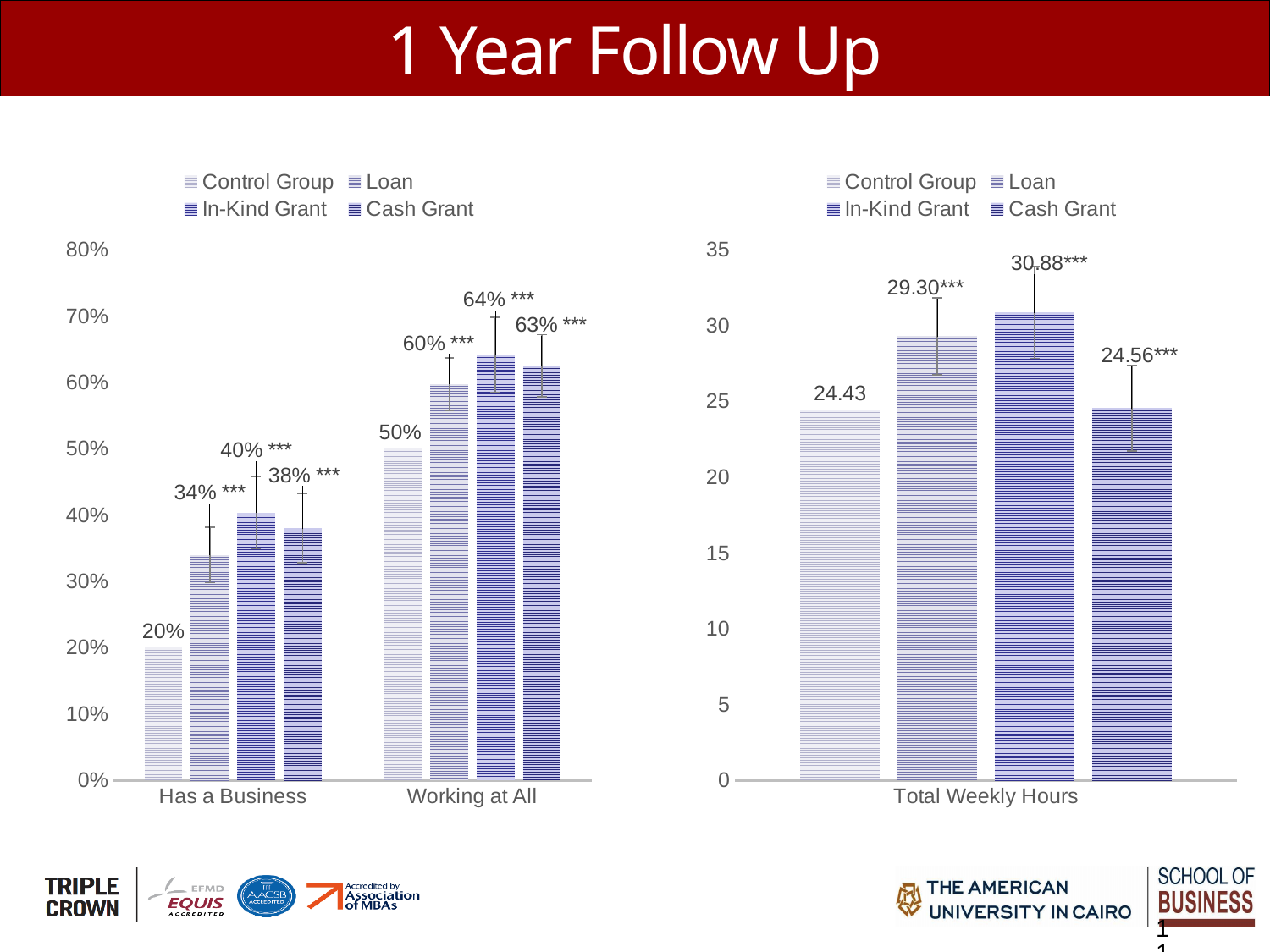
On the left chart, which group has the highest value in the Has a Business category? In-Kind Grant On the left chart, what is the difference between the Loan and Control Group values in the Has a Business category? 14% On the left chart, what is the value for the Control Group in the Has a Business category? 20% On the left chart, how many categories are shown on the x axis? 2 On the left chart, how many series does the legend list? 4 On the right chart, is the value for the Loan group greater or less than 25? greater What kind of chart is the right chart? Bar chart On the left chart, which group has the lowest value in the Working at All category? Control Group On the right chart, what is the value for the Loan group for Total Weekly Hours? 29.30 On the right chart, which group has the highest Total Weekly Hours? In-Kind Grant On the right chart, which group has the lowest Total Weekly Hours? Control Group On the left chart, what is the value for the In-Kind Grant group in the Working at All category? 64%